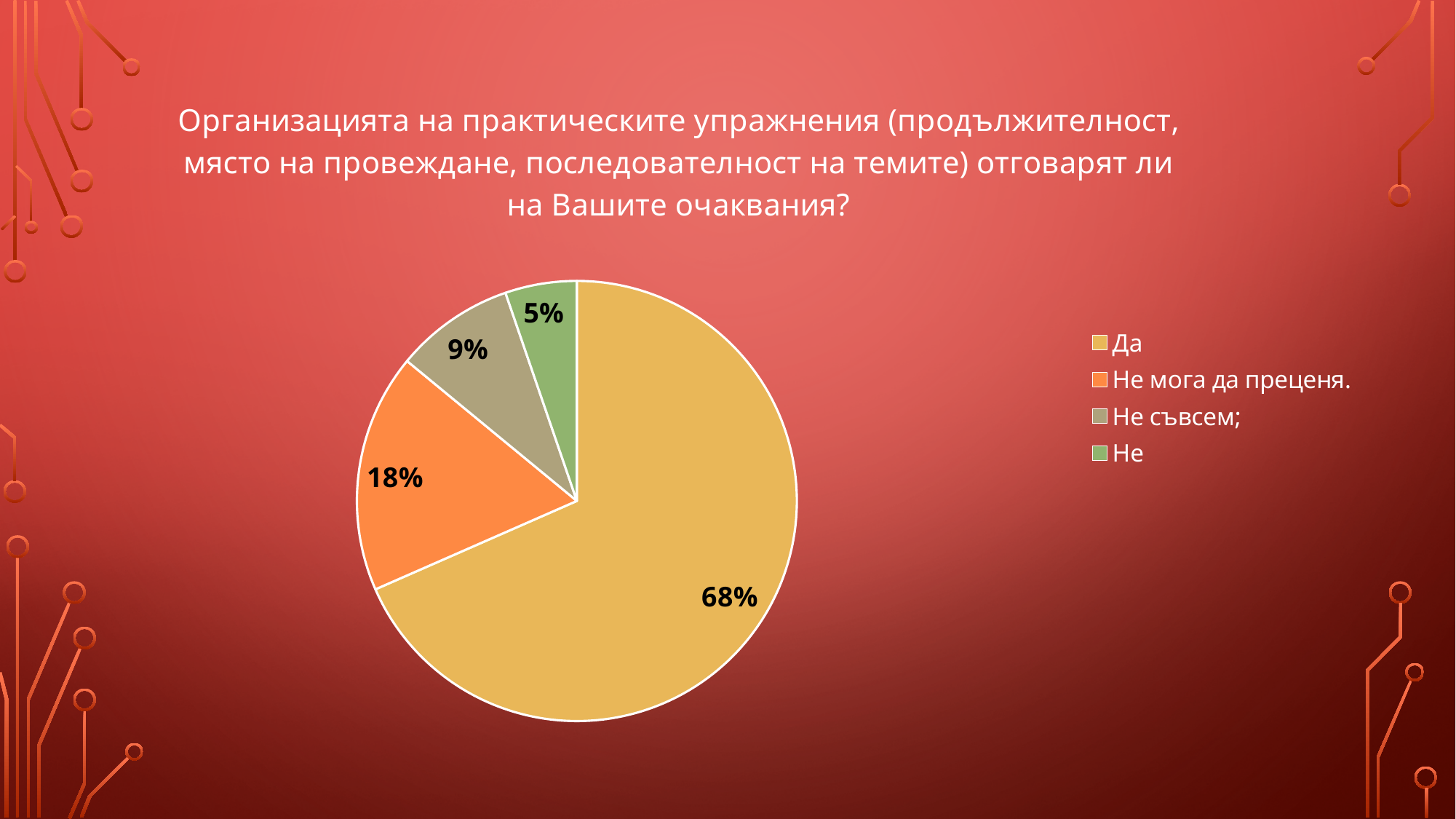
What share of the pie does "Не" have? 5% Which is larger, the share for "Не съвсем;" or the share for "Не"? Не съвсем; What kind of chart is shown on the slide? pie chart What share of the pie does "Да" have? 68% What share of the pie does "Не съвсем;" have? 9% How many categories does the pie chart have? 4 Which category has the smallest slice of the pie? Не Which category has the largest slice of the pie? Да What colour is the slice for "Не мога да преценя."? orange What is the difference between the shares of "Да" and "Не мога да преценя."? 50% How many entries does the legend list? 4